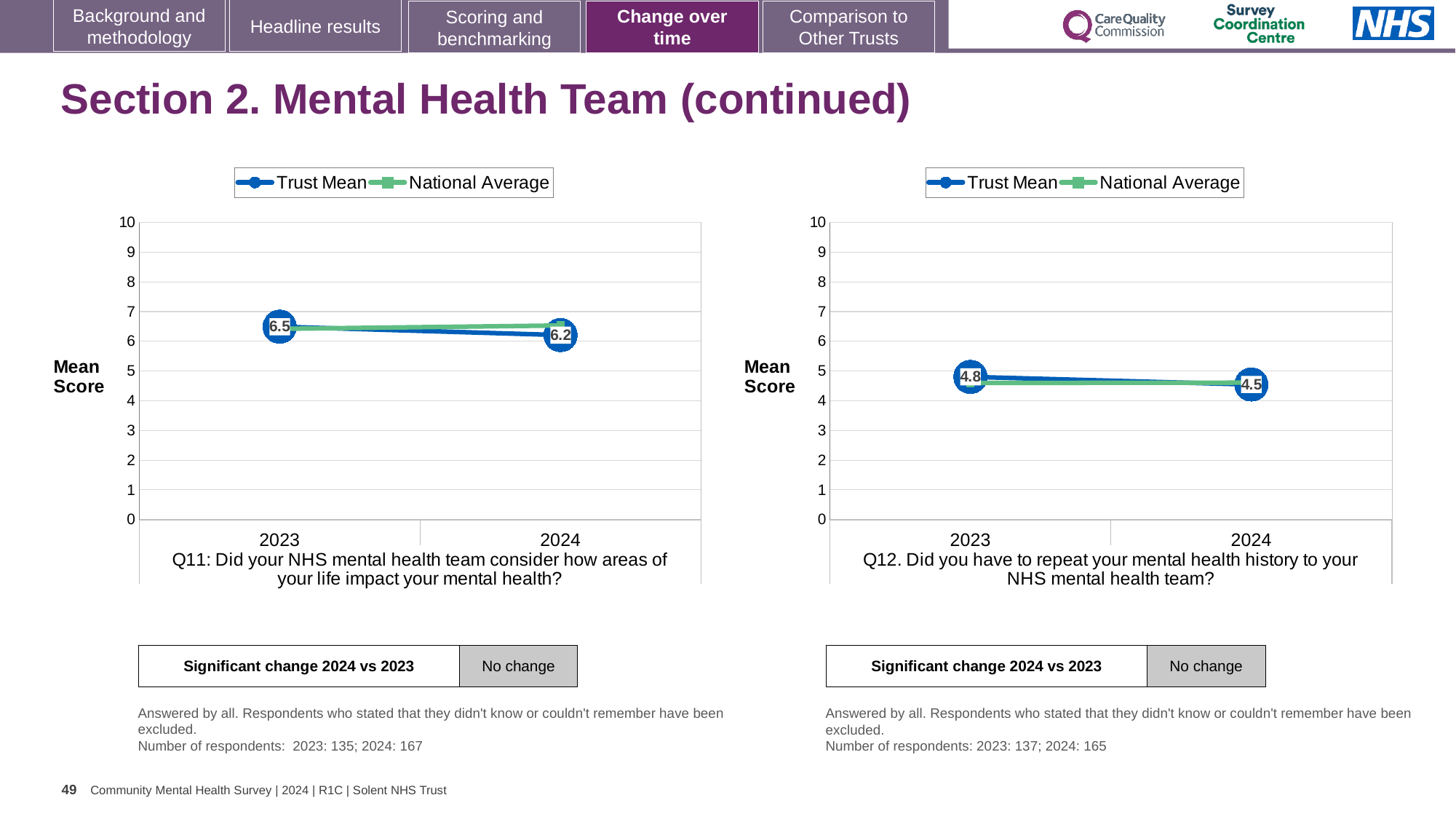
In the right chart (Q12), what is the Trust Mean value for 2024? 4.5 In the right chart (Q12), is the National Average for 2023 greater or less than 5? less In the left chart (Q11), by how much did the Trust Mean change from 2023 to 2024? 0.3 In the left chart (Q11), is the National Average for 2023 greater or less than 6? greater In the right chart (Q12), does the Trust Mean rise or fall from 2023 to 2024? fall In the left chart (Q11), which year has the higher Trust Mean, 2023 or 2024? 2023 How many series does the legend of the left chart (Q11) list? 2 What kind of chart is the right chart (Q12)? line chart In the right chart (Q12), what is the difference between the Trust Mean in 2023 and in 2024? 0.3 In the left chart (Q11), what is the Trust Mean value for 2023? 6.5 In the left chart (Q11), what is the Trust Mean value for 2024? 6.2 In the right chart (Q12), what is the Trust Mean value for 2023? 4.8